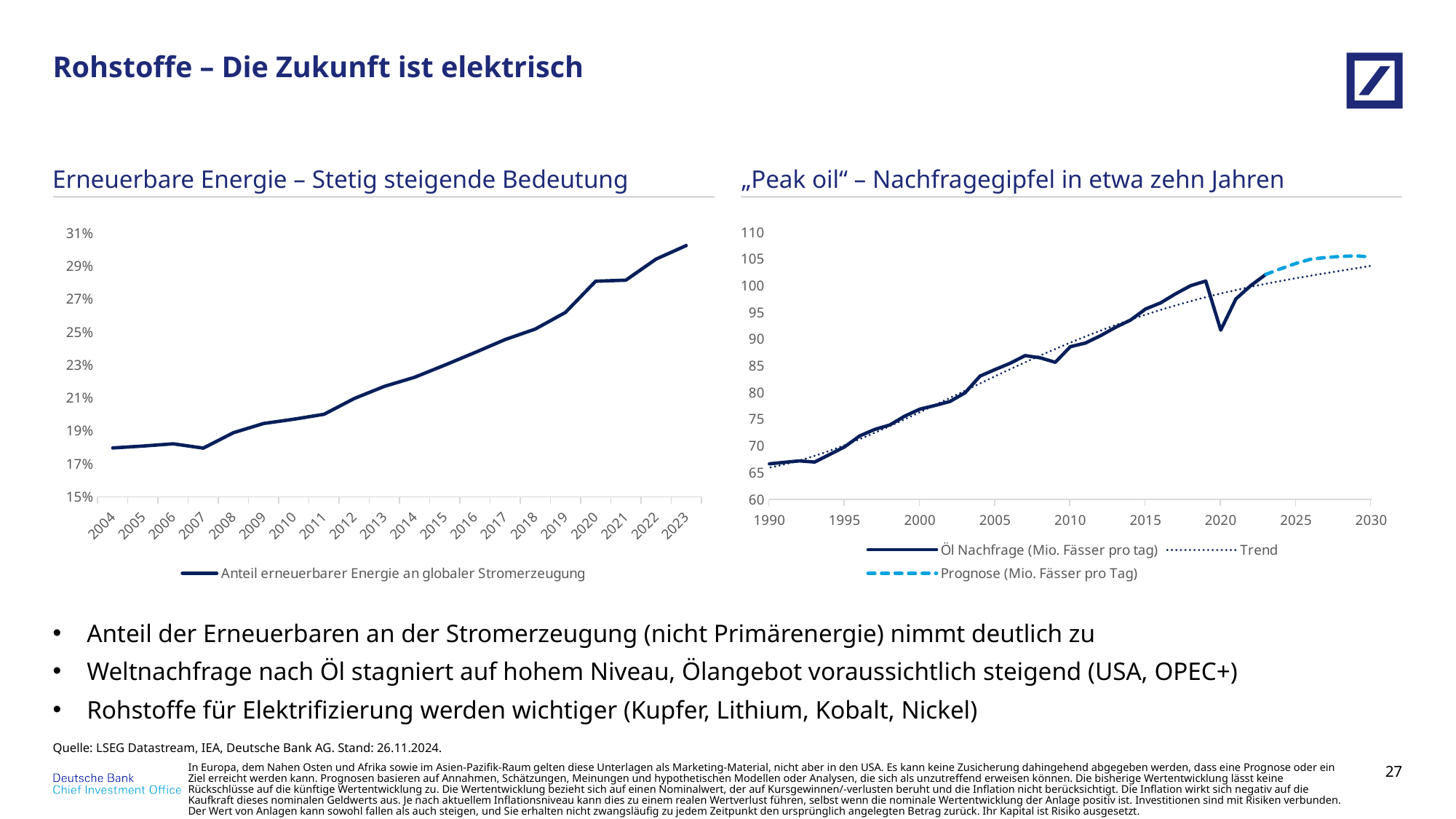
What kind of chart is the left chart titled "Erneuerbare Energie – Stetig steigende Bedeutung"? line chart In the right chart, is the oil demand value for 2020 greater or less than 95? less What kind of chart is the right chart titled "„Peak oil“ – Nachfragegipfel in etwa zehn Jahren"? line chart In the right chart, which series is drawn as a dashed light-blue line? Prognose (Mio. Fässer pro Tag) In the left chart, which year has the highest share of renewable energy? 2023 How many series does the legend of the right chart list? 3 In the left chart, does the share of renewable energy rise or fall from 2004 to 2023? rise In the left chart, how many years are labelled on the x axis? 20 In the left chart, is the value for 2004 greater or less than 19%? less In the left chart, is the value for 2023 greater or less than 29%? greater